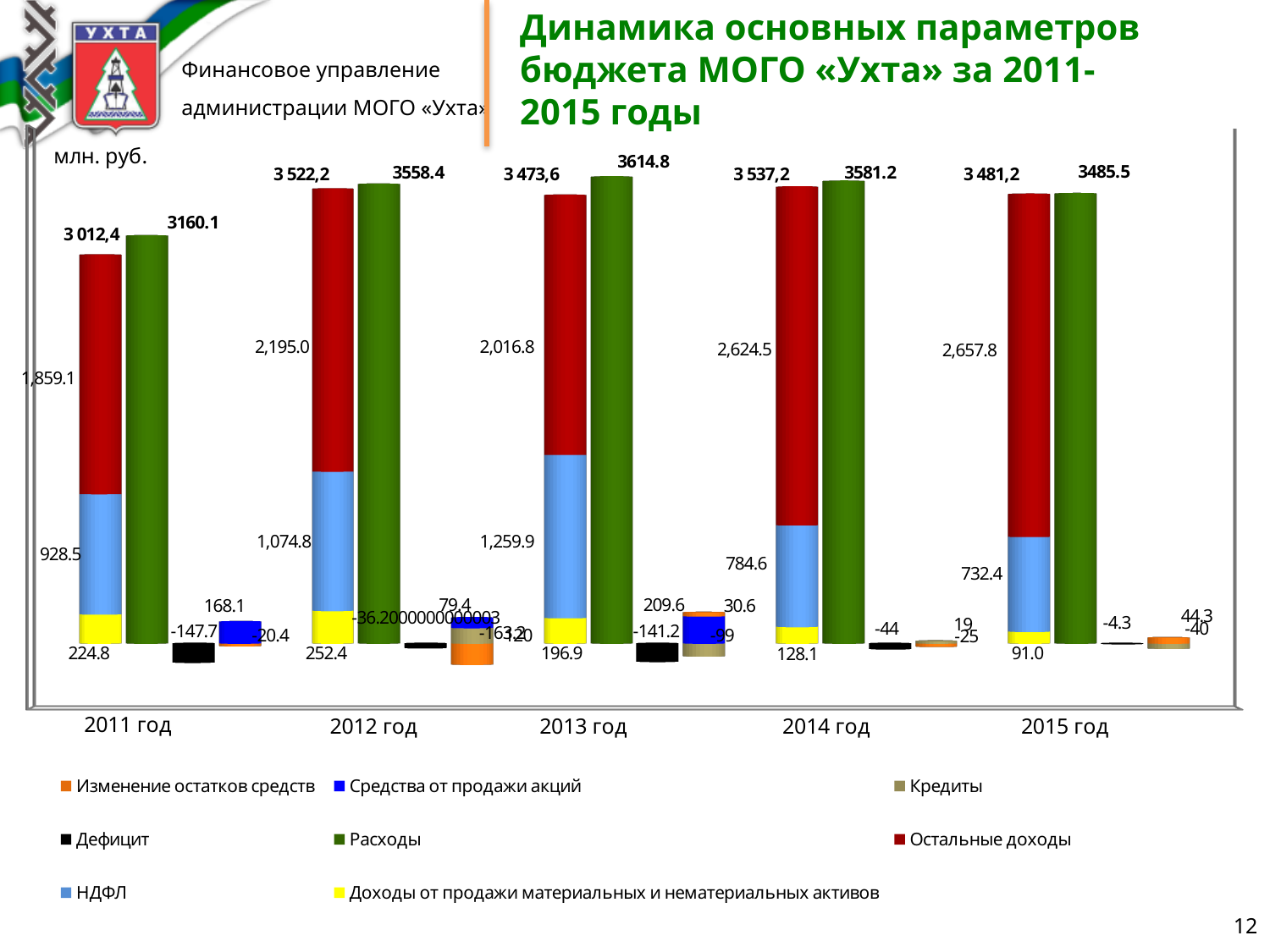
What unit of measurement is indicated for the chart? млн. руб. In which year is the value of Расходы the lowest? 2011 год What kind of chart is shown on the slide? bar chart By how much did Расходы increase from 2011 год to 2012 год? 398.3 Which year has the larger value of НДФЛ, 2012 год or 2013 год? 2013 год What is the total of the stacked income bar for 2014 год? 3 537,2 What is the value of Расходы for 2013 год? 3614.8 What is the value of Остальные доходы for 2015 год? 2,657.8 How many year categories are shown on the x axis? 5 In which year is the value of Расходы the highest? 2013 год How many series does the legend list? 8 What is the value of НДФЛ for 2014 год? 784.6